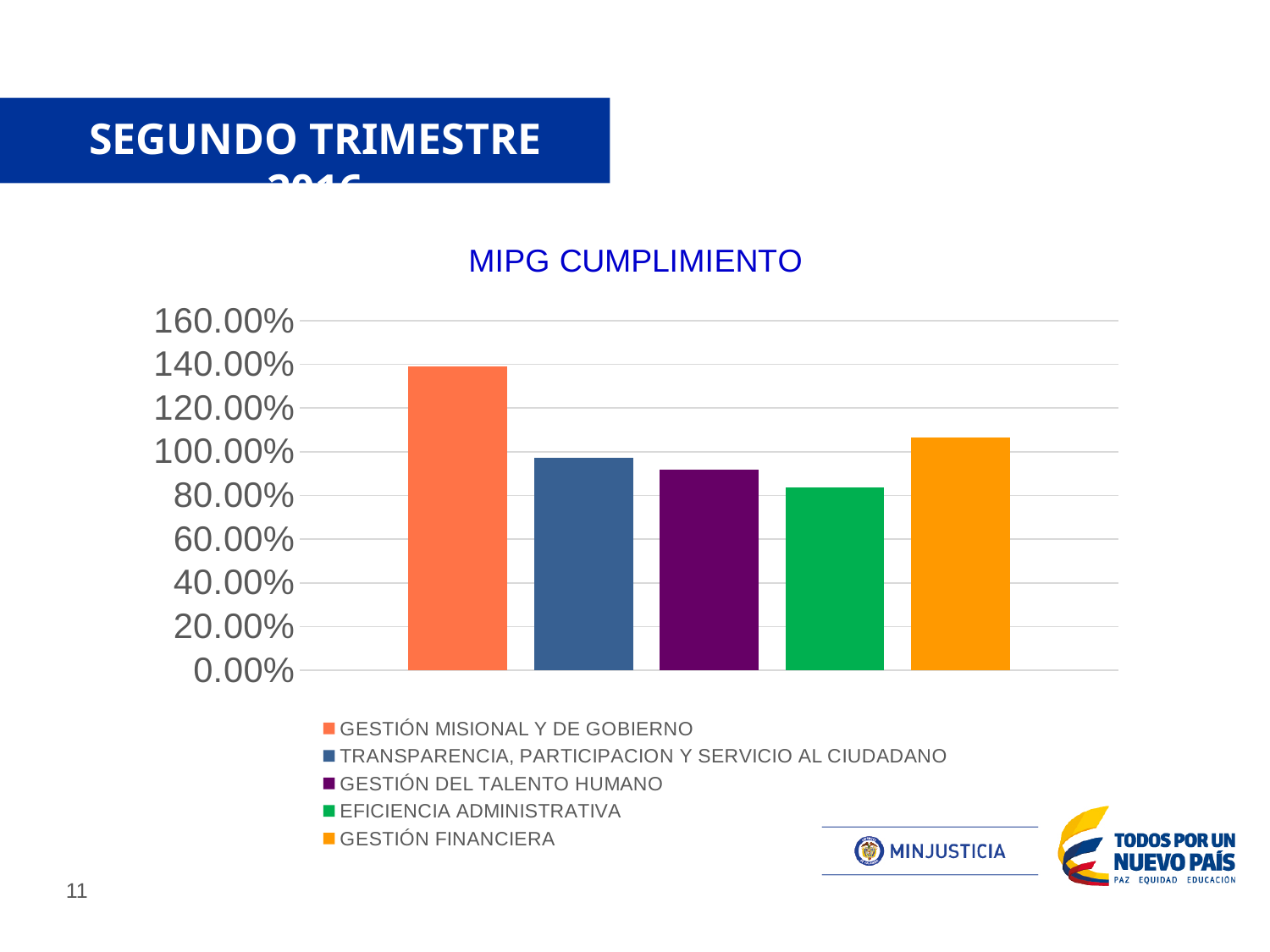
Which category has the lowest value? EFICIENCIA ADMINISTRATIVA Which is larger, the value for GESTIÓN FINANCIERA or the value for EFICIENCIA ADMINISTRATIVA? GESTIÓN FINANCIERA Is the value for GESTIÓN MISIONAL Y DE GOBIERNO greater or less than 120.00%? greater What is the title of the chart? MIPG CUMPLIMIENTO Is the value for GESTIÓN FINANCIERA greater or less than 100.00%? greater Is the value for EFICIENCIA ADMINISTRATIVA greater or less than 100.00%? less How many entries does the legend list? 5 Which category has the highest value? GESTIÓN MISIONAL Y DE GOBIERNO How many bars are plotted in the chart? 5 What kind of chart is shown on the slide? bar chart Which is larger, the value for GESTIÓN MISIONAL Y DE GOBIERNO or the value for GESTIÓN FINANCIERA? GESTIÓN MISIONAL Y DE GOBIERNO